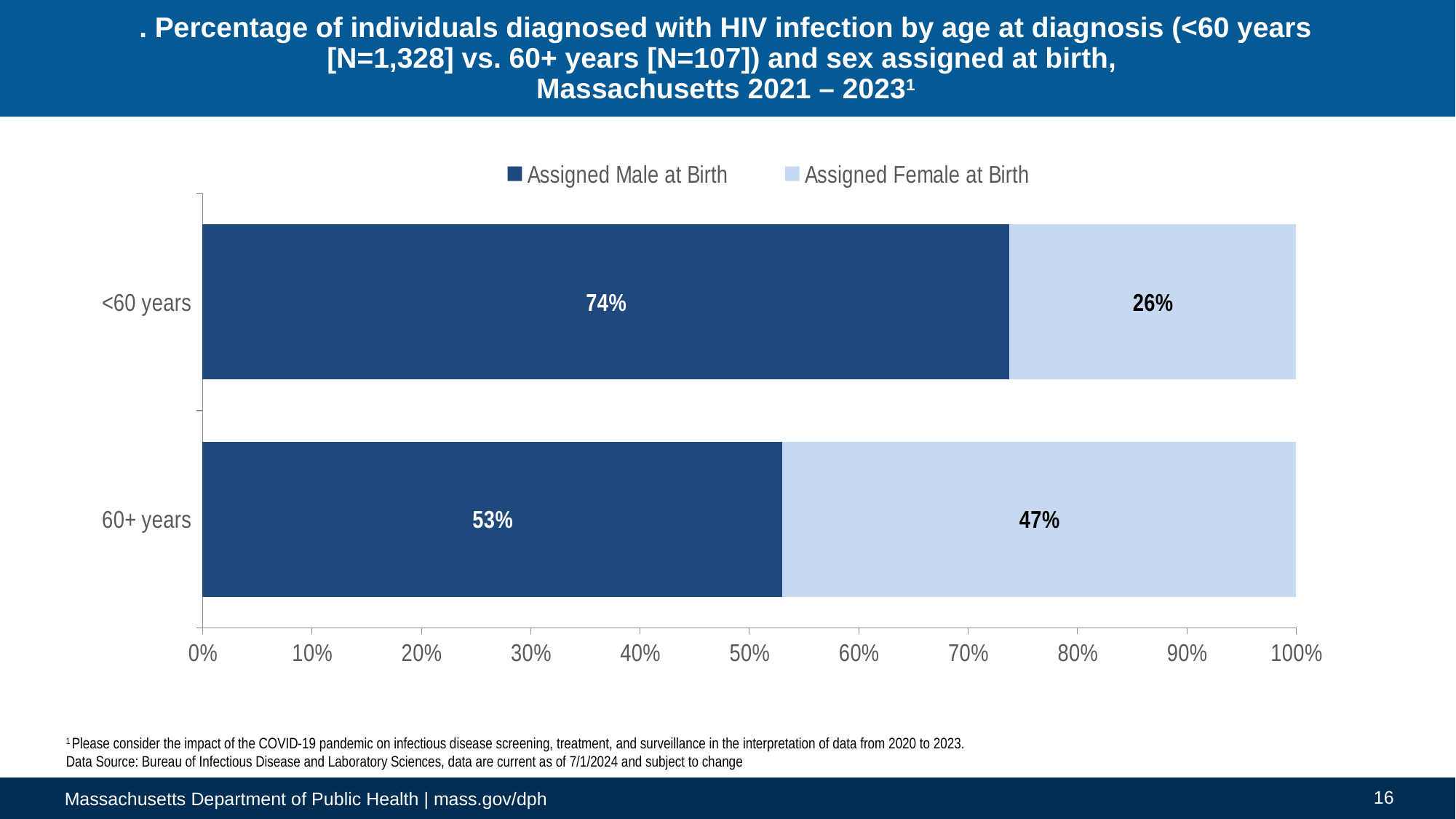
What type of chart is shown on the slide? Stacked bar chart What percentage of individuals diagnosed at <60 years were assigned female at birth? 26% Which age group has the higher percentage assigned male at birth? <60 years What is the difference in the Assigned Male at Birth percentage between the <60 years and 60+ years groups? 21 percentage points How many series does the legend list? 2 What is the total of the two segments in the 60+ years bar? 100% Is the Assigned Female at Birth percentage larger for the <60 years group or the 60+ years group? 60+ years What percentage of individuals diagnosed with HIV at <60 years were assigned male at birth? 74% Which age group has the lower percentage assigned female at birth? <60 years What percentage of individuals diagnosed at 60+ years were assigned male at birth? 53% How many age groups are shown on the chart? 2 What percentage of individuals diagnosed with HIV at 60+ years were assigned female at birth? 47%